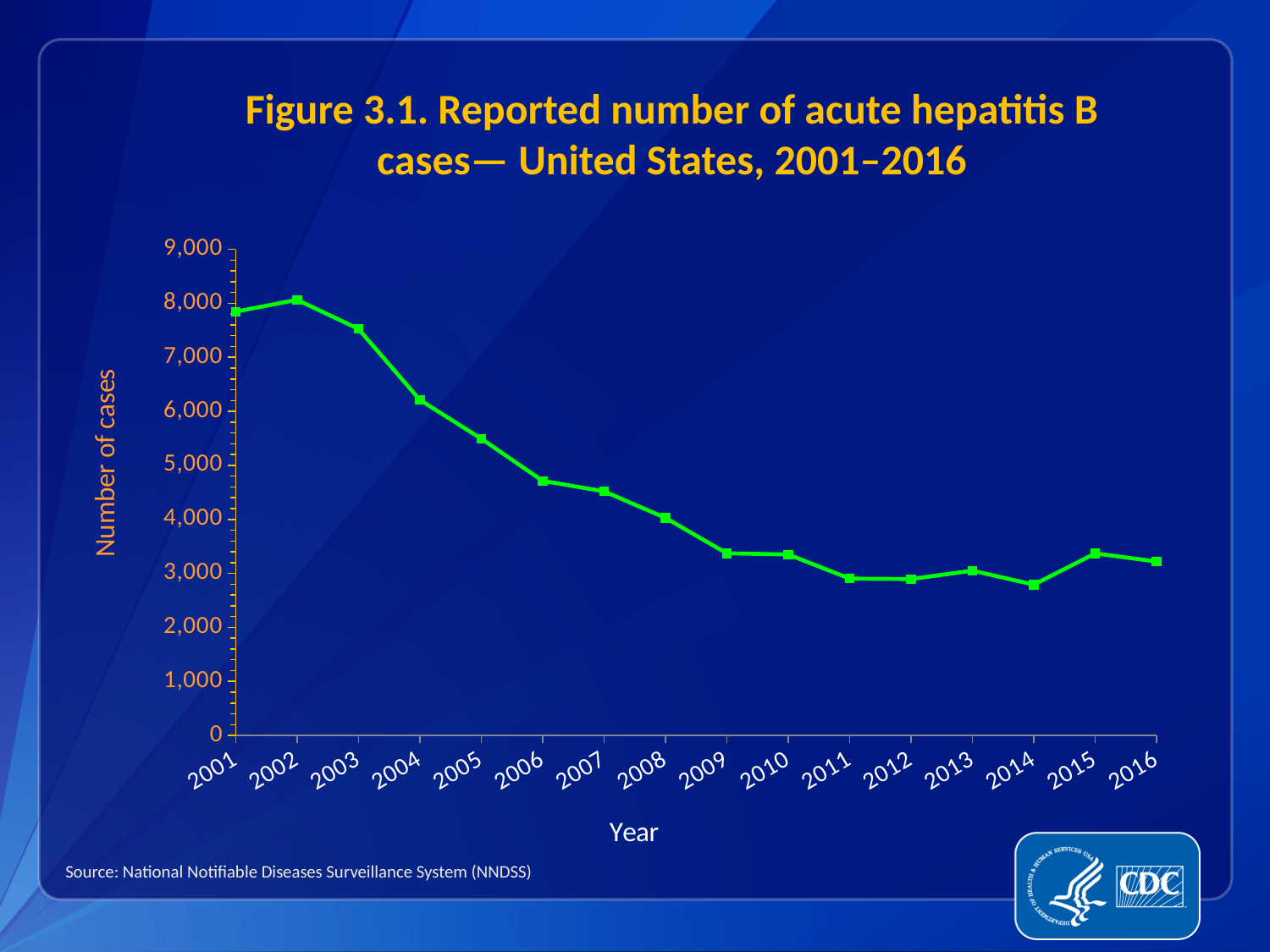
What kind of chart is shown on the slide? Line chart Overall, do the reported cases rise or fall from 2001 to 2016? Fall Is the value for 2014 greater or less than 3,000? less Which year has more reported cases, 2004 or 2008? 2004 In which year was the reported number of acute hepatitis B cases highest? 2002 Is the value for 2004 greater or less than 6,000? greater Is the value for 2001 greater or less than 7,000? greater Which year has more reported cases, 2003 or 2015? 2003 What is the label of the x axis? Year What is the label of the y axis? Number of cases How many years are plotted on the x axis? 16